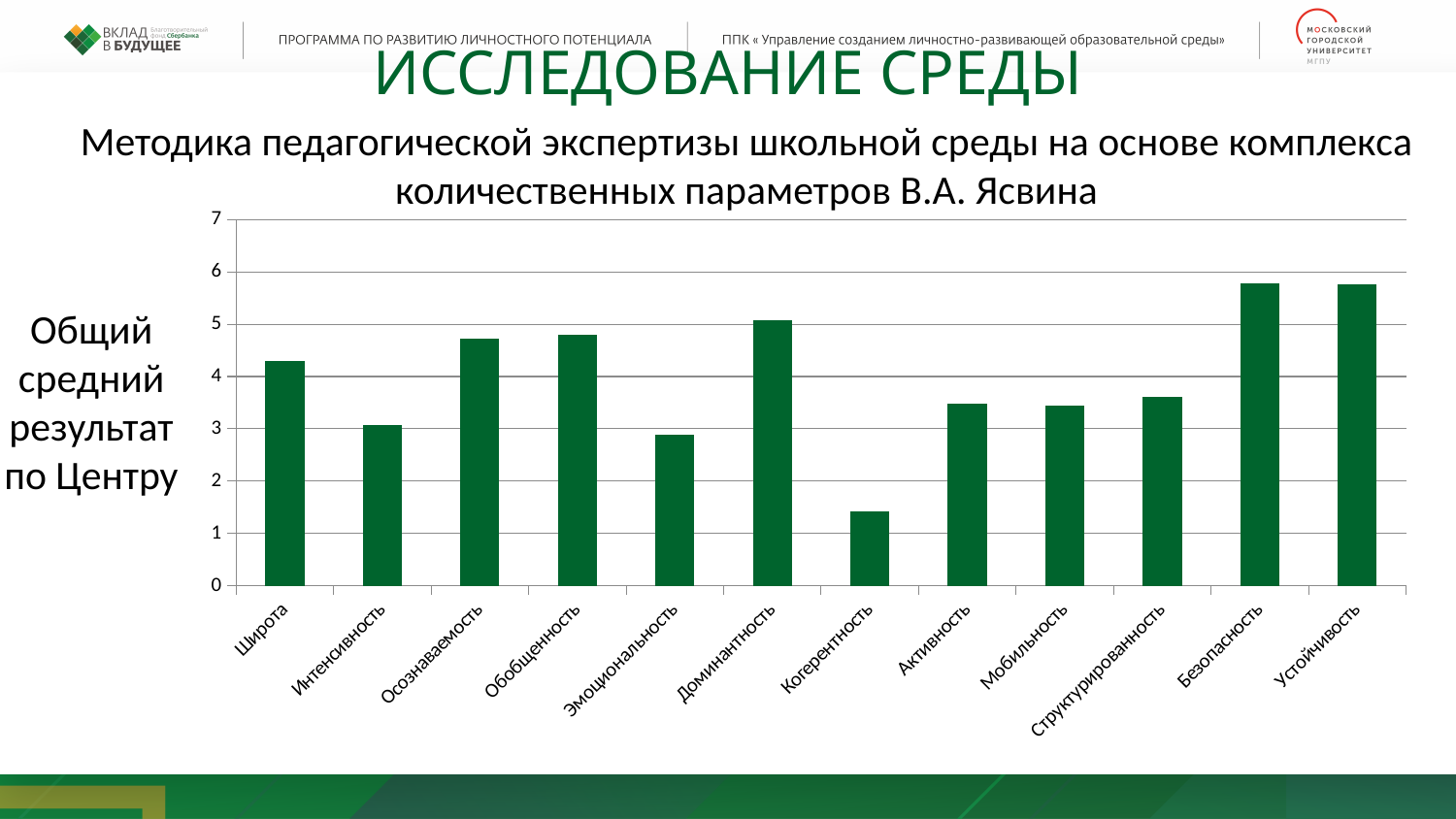
Which is larger, the value for Эмоциональность or the value for Осознаваемость? Осознаваемость Is the value for Когерентность greater or less than 2? less Which is larger, the value for Доминантность or the value for Интенсивность? Доминантность How many categories are plotted along the x axis of the chart? 12 What is the highest value shown on the vertical axis of the chart? 7 Is the value for Широта greater or less than 4? greater Which category has the lowest bar in the chart? Когерентность What kind of chart is shown on the slide? bar chart What colour are the bars in the chart? green Is the value for Безопасность greater or less than 5? greater